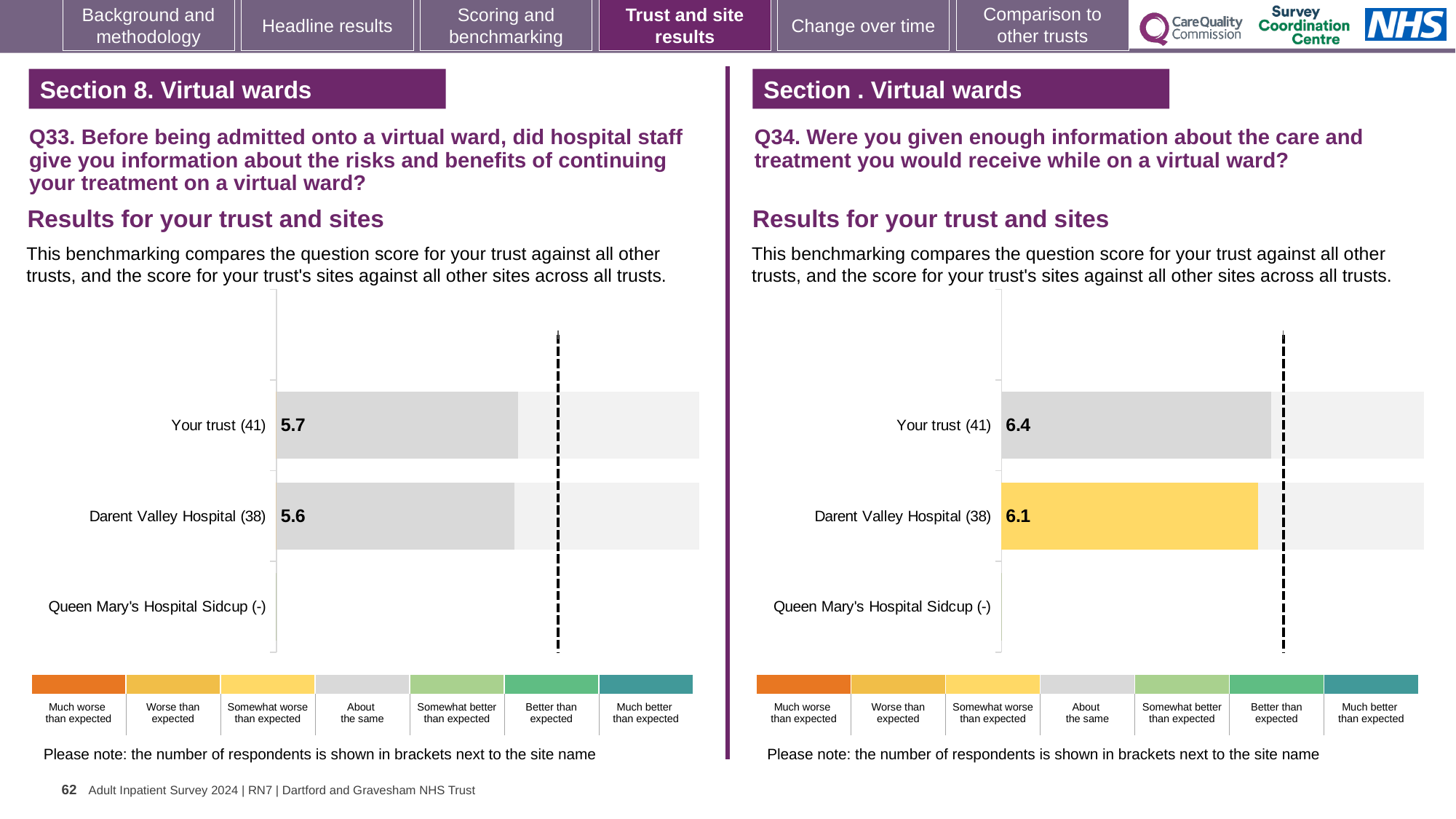
In the Q33 chart on the left, what is the difference between the score for Your trust and the score for Darent Valley Hospital? 0.1 In the Q34 chart on the right, what is the score for Darent Valley Hospital? 6.1 In the Q34 chart on the right, what is the score for Your trust? 6.4 In the Q33 chart on the left, what is the score for Your trust? 5.7 How many respondents are shown in brackets for Darent Valley Hospital in the Q33 chart on the left? 38 In the Q34 chart on the right, which benchmark category does the colour of the Darent Valley Hospital bar correspond to in the legend? Somewhat worse than expected In the Q34 chart on the right, what is the difference between the score for Your trust and the score for Darent Valley Hospital? 0.3 What kind of chart is the Q33 chart on the left? Bar chart In the Q34 chart on the right, which has the higher score, Your trust or Darent Valley Hospital? Your trust How many benchmark categories does the legend below the Q33 chart on the left list? 7 In the Q33 chart on the left, what is the score for Darent Valley Hospital? 5.6 How many site or trust rows are listed on the y axis of the Q34 chart on the right? 3